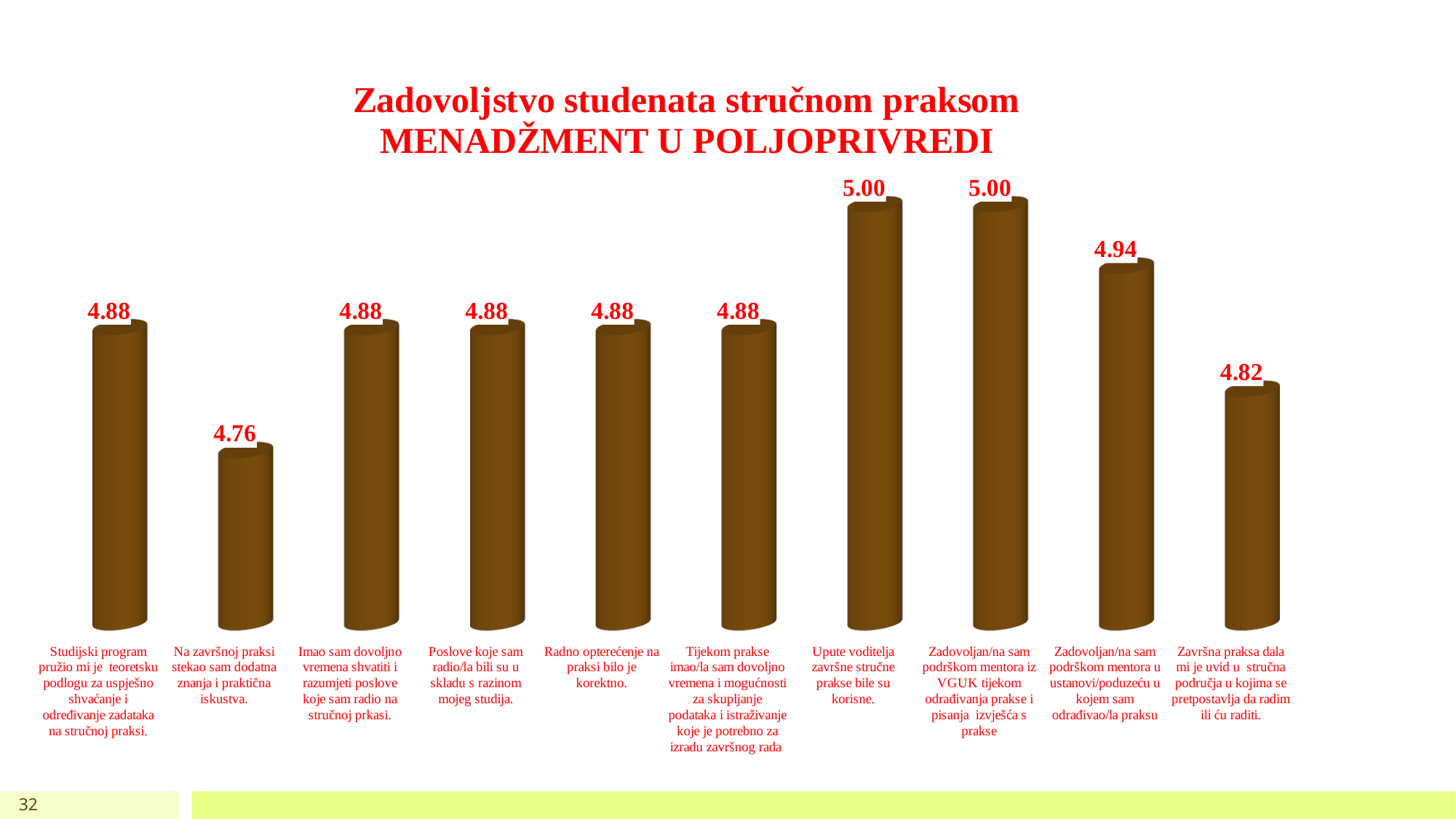
What is the difference between the value for "Upute voditelja završne stručne prakse bile su korisne." and the value for "Na završnoj praksi stekao sam dodatna znanja i praktična iskustva."? 0.24 What is the title of the chart? Zadovoljstvo studenata stručnom praksom MENADŽMENT U POLJOPRIVREDI What is the highest value shown in the chart? 5.00 What is the value for "Na završnoj praksi stekao sam dodatna znanja i praktična iskustva."? 4.76 What is the value for "Završna praksa dala mi je uvid u stručna područja u kojima se pretpostavlja da radim ili ću raditi."? 4.82 Which is larger: the value for "Radno opterećenje na praksi bilo je korektno." or the value for "Završna praksa dala mi je uvid u stručna područja u kojima se pretpostavlja da radim ili ću raditi."? Radno opterećenje na praksi bilo je korektno. What is the value for "Zadovoljan/na sam podrškom mentora u ustanovi/poduzeću u kojem sam odrađivao/la praksu"? 4.94 How many categories are shown in the chart? 10 Which category has the lowest value? Na završnoj praksi stekao sam dodatna znanja i praktična iskustva. What is the value for "Upute voditelja završne stručne prakse bile su korisne."? 5.00 What is the difference between the value for "Zadovoljan/na sam podrškom mentora u ustanovi/poduzeću u kojem sam odrađivao/la praksu" and the value for "Završna praksa dala mi je uvid u stručna područja u kojima se pretpostavlja da radim ili ću raditi."? 0.12 What kind of chart is shown on the slide? Bar chart